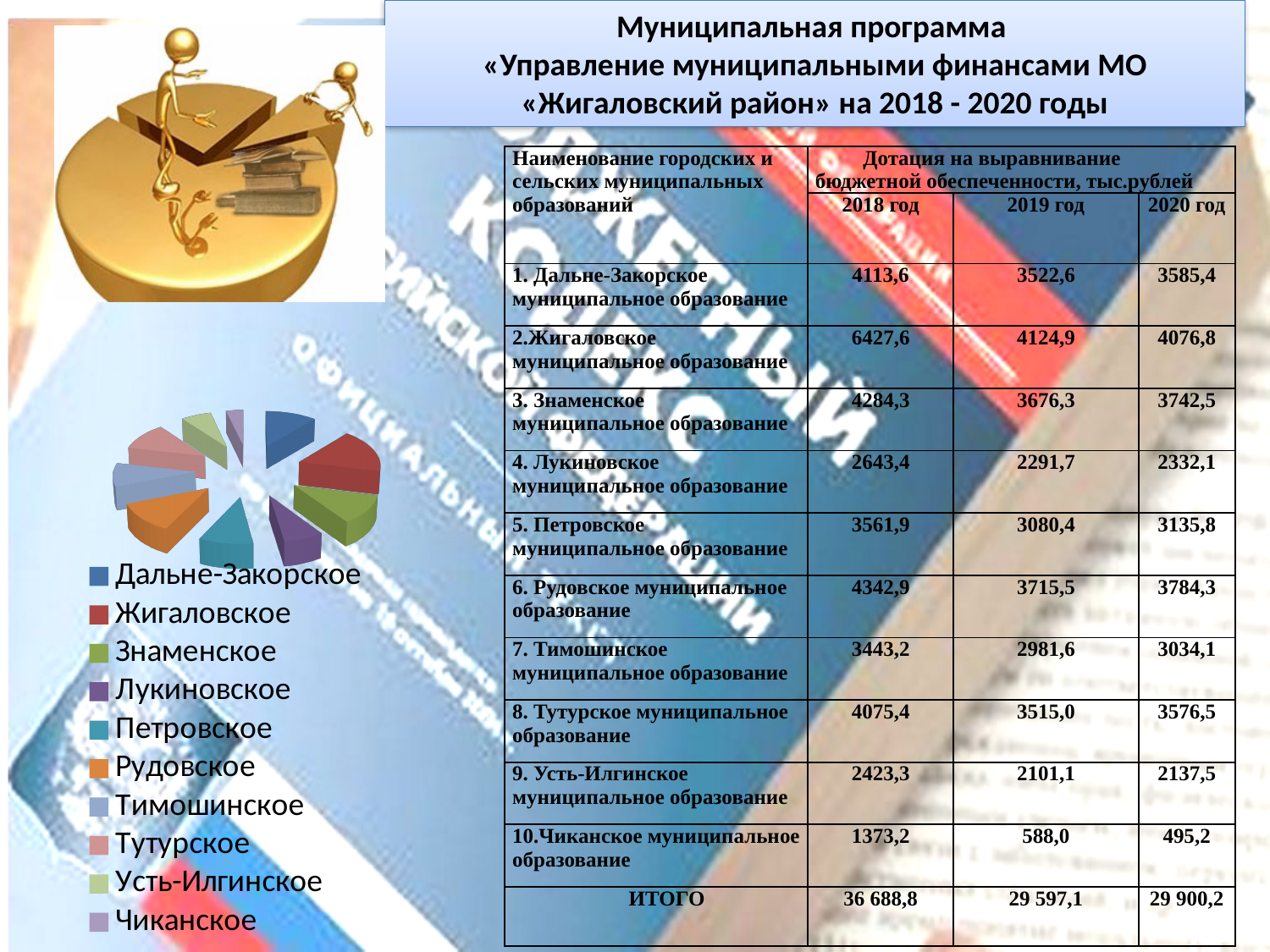
In the pie chart, which slice is larger: Жигаловское or Чиканское? Жигаловское Which category has the largest slice in the pie chart? Жигаловское How many categories does the pie chart's legend list? 10 What kind of chart is shown on the left side of the slide? pie chart What colour is the Дальне-Закорское slice in the pie chart? blue Which category has the smallest slice in the pie chart? Чиканское Which category is listed first in the pie chart's legend? Дальне-Закорское In the pie chart, which slice is larger: Лукиновское or Чиканское? Лукиновское